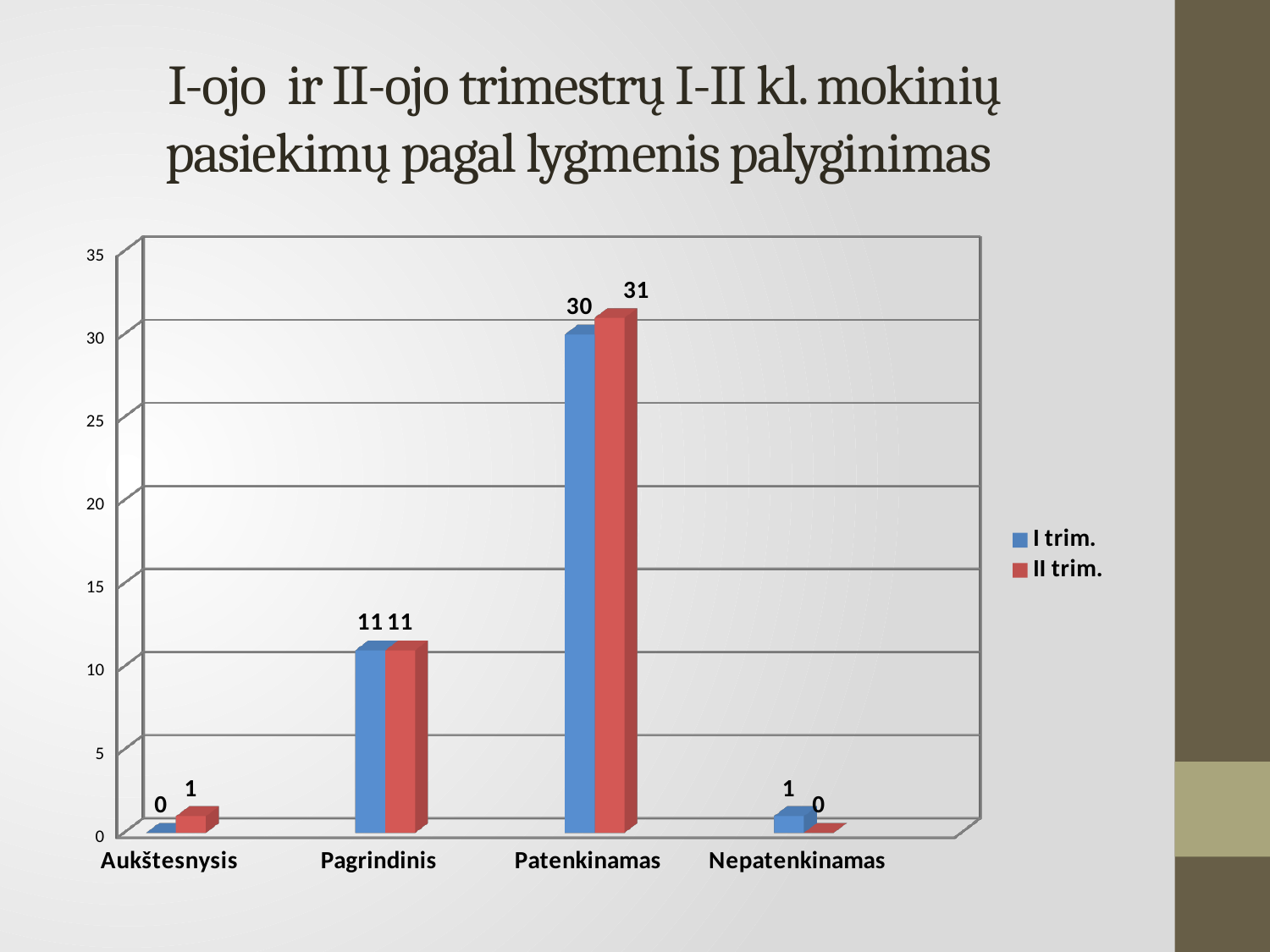
What is the difference between the II trim. and I trim. values for Patenkinamas? 1 Which colour represents the II trim. series in the legend? Red What kind of chart is shown on the slide? Bar chart How many series does the legend list? 2 What is the value for Pagrindinis in the I trim. series? 11 Which is larger for Patenkinamas, the I trim. value or the II trim. value? II trim. Which category has the highest value in the I trim. series? Patenkinamas What is the value for Patenkinamas in the II trim. series? 31 What is the value for Nepatenkinamas in the I trim. series? 1 What is the value for Aukštesnysis in the II trim. series? 1 Which category has the lowest value in the II trim. series? Nepatenkinamas How many categories are shown on the x axis? 4